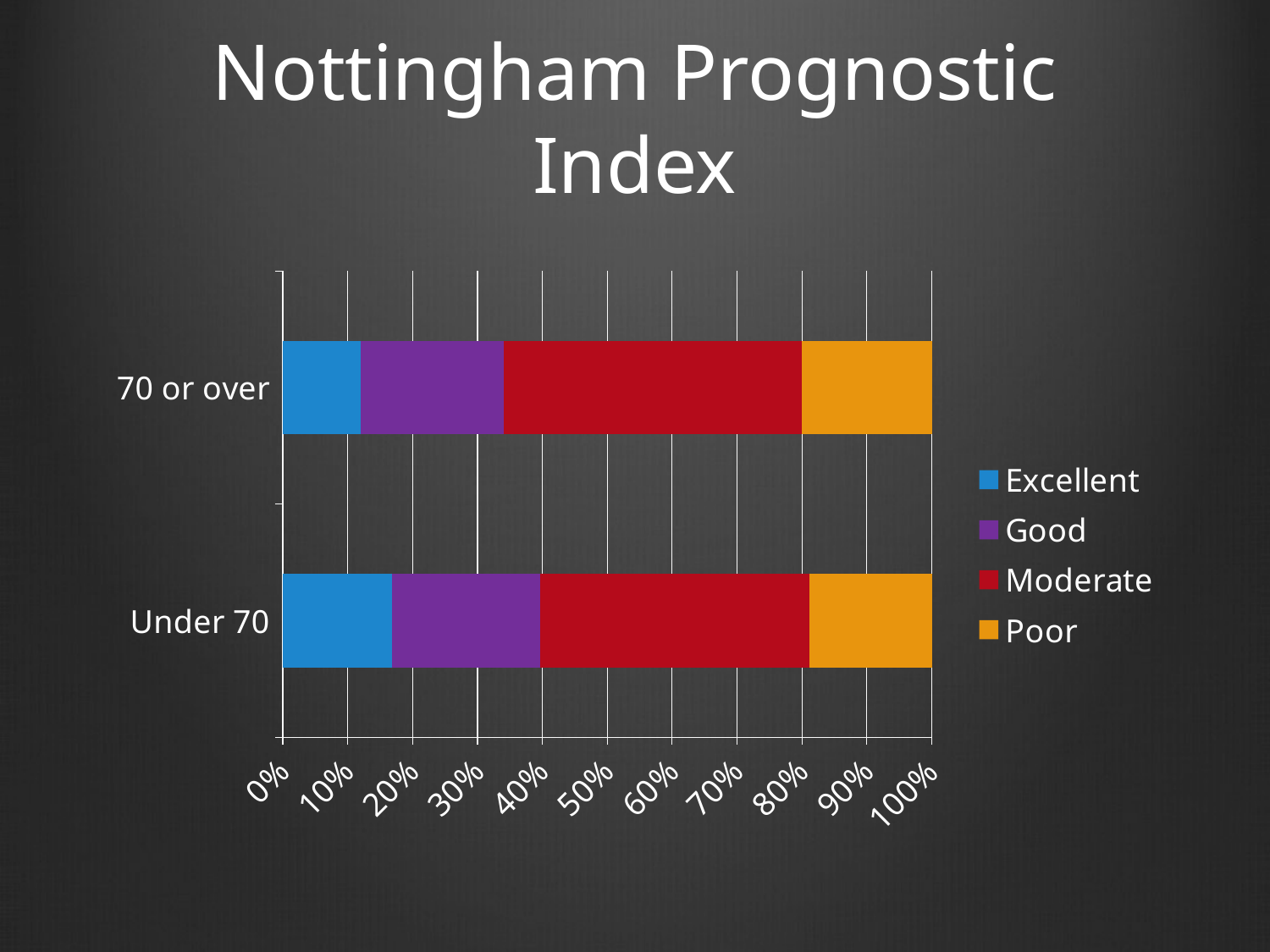
Which age group has the larger Moderate share, Under 70 or 70 or over? 70 or over Is the Excellent share for Under 70 greater or less than 10%? greater Is the Poor share for Under 70 greater or less than 30%? less How many series does the legend list? 4 How many age categories are plotted on the chart? 2 What is the title of the chart? Nottingham Prognostic Index What does each stacked bar total on the x axis? 100% What kind of chart is shown on the slide? Stacked bar chart Is the Moderate share for 70 or over greater or less than 40%? greater Which age group has the larger Excellent share, Under 70 or 70 or over? Under 70 Which colour represents the Moderate series in the legend? Red